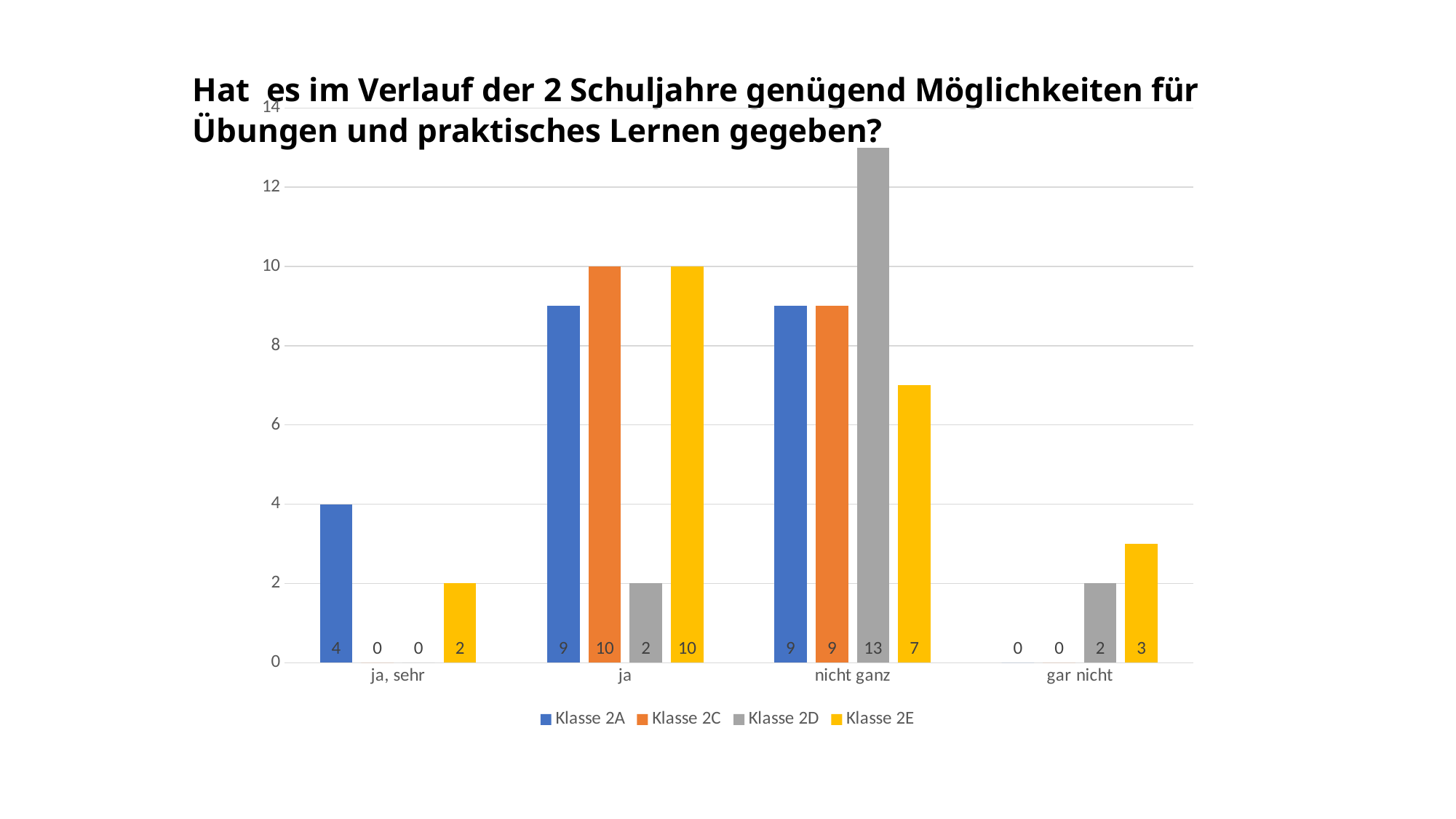
What value does Klasse 2E have for "gar nicht"? 3 Is the value for Klasse 2D at "nicht ganz" greater or less than 12? greater What value does Klasse 2D have for "nicht ganz"? 13 Which series has the highest value for "nicht ganz"? Klasse 2D What value does Klasse 2A have for "ja, sehr"? 4 How many categories are shown on the x axis? 4 Which is larger for "ja": Klasse 2A or Klasse 2C? Klasse 2C How many series does the legend list? 4 What kind of chart is shown on the slide? bar chart What is the difference between Klasse 2D and Klasse 2E for "nicht ganz"? 6 Which series has the lowest value for "ja"? Klasse 2D Which colour represents Klasse 2E in the chart? yellow